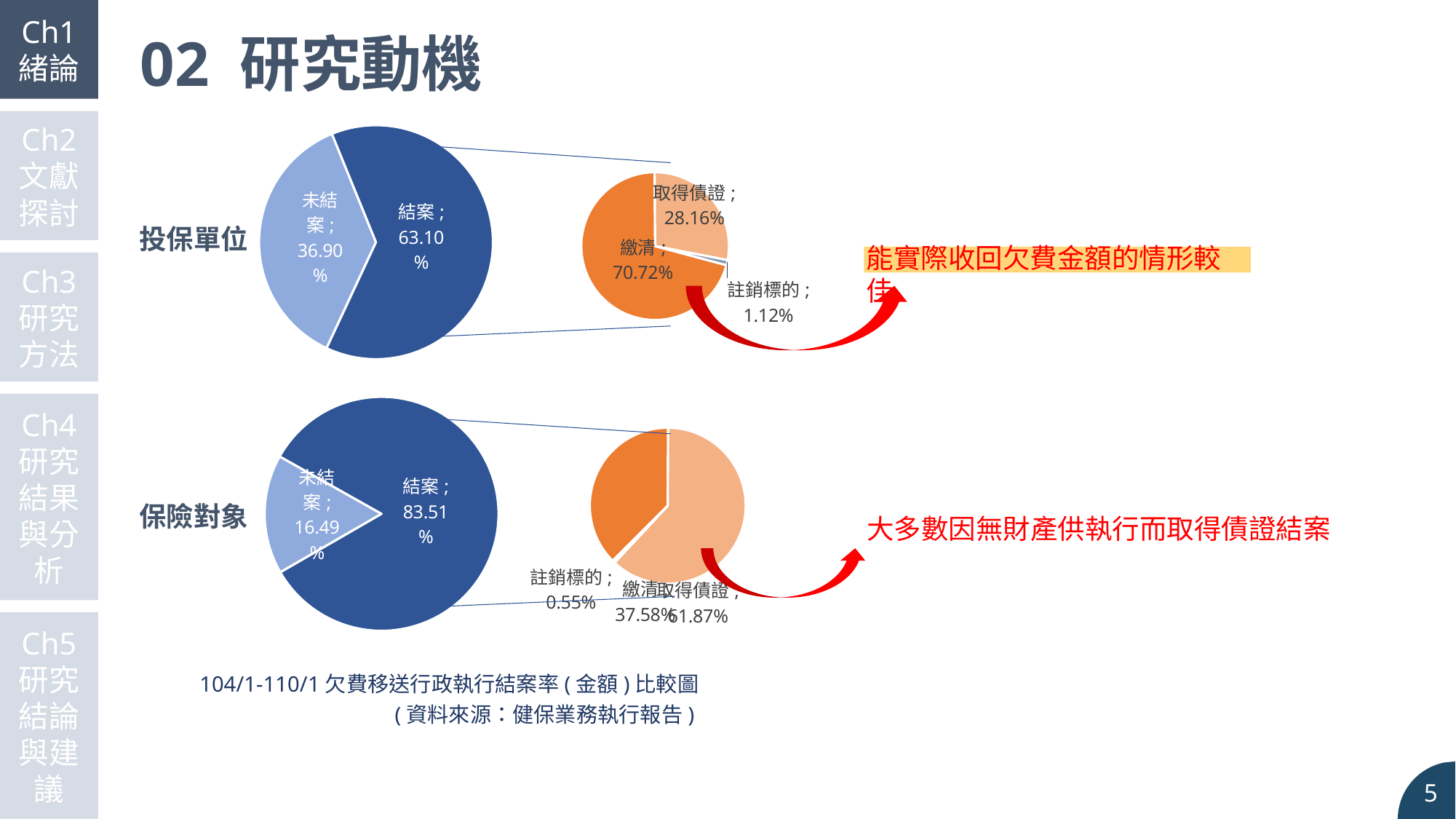
In the 保險對象 chart's secondary pie, what percentage is labelled 繳清? 37.58% In the 投保單位 chart, what percentage is labelled 未結案? 36.90% Which is larger: the 取得債證 share in the 投保單位 chart or the 取得債證 share in the 保險對象 chart? 保險對象 In the 保險對象 chart, what percentage is labelled 結案? 83.51% What is the difference between the 結案 share in the 保險對象 chart and the 結案 share in the 投保單位 chart? 20.41% In the 投保單位 chart's secondary pie, what percentage is labelled 繳清? 70.72% In the 保險對象 chart's secondary pie, what percentage is labelled 取得債證? 61.87% What type of chart is used for 投保單位 and 保險對象 on this slide? Pie chart In the 投保單位 chart's secondary pie, which category has the largest share? 繳清 In the 保險對象 chart's secondary pie, which category has the smallest share? 註銷標的 In the 投保單位 chart's secondary pie, what percentage is labelled 註銷標的? 1.12% In the 投保單位 chart, what percentage is labelled 結案? 63.10%